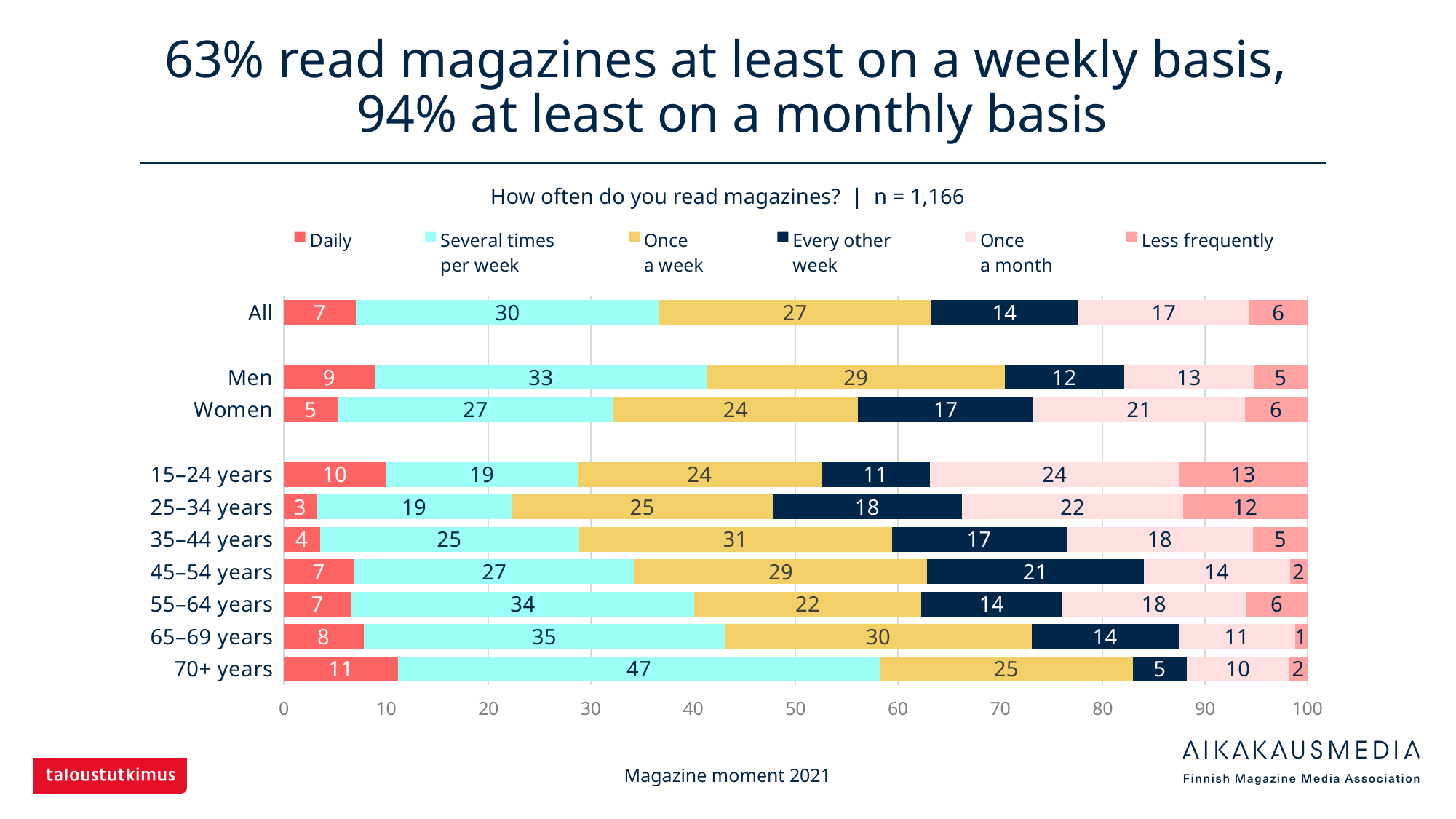
What is the 'Several times per week' value for the 70+ years group? 47 What is the 'Once a week' value for the 35–44 years group? 31 What is the difference between the 'Daily' values for Men and Women? 4 What is the sample size (n) stated in the chart subtitle? n = 1,166 Which group has the highest 'Daily' value? 70+ years How many series does the legend list? 6 Which is larger, the 'Once a week' value for 35–44 years or for 45–54 years? 35–44 years What is the total of the stacked bar for Women? 100 Which group has the lowest 'Daily' value? 25–34 years What type of chart is shown on the slide? Stacked bar chart What is the 'Every other week' value for Women? 17 How many categories (groups) are plotted on the chart? 10